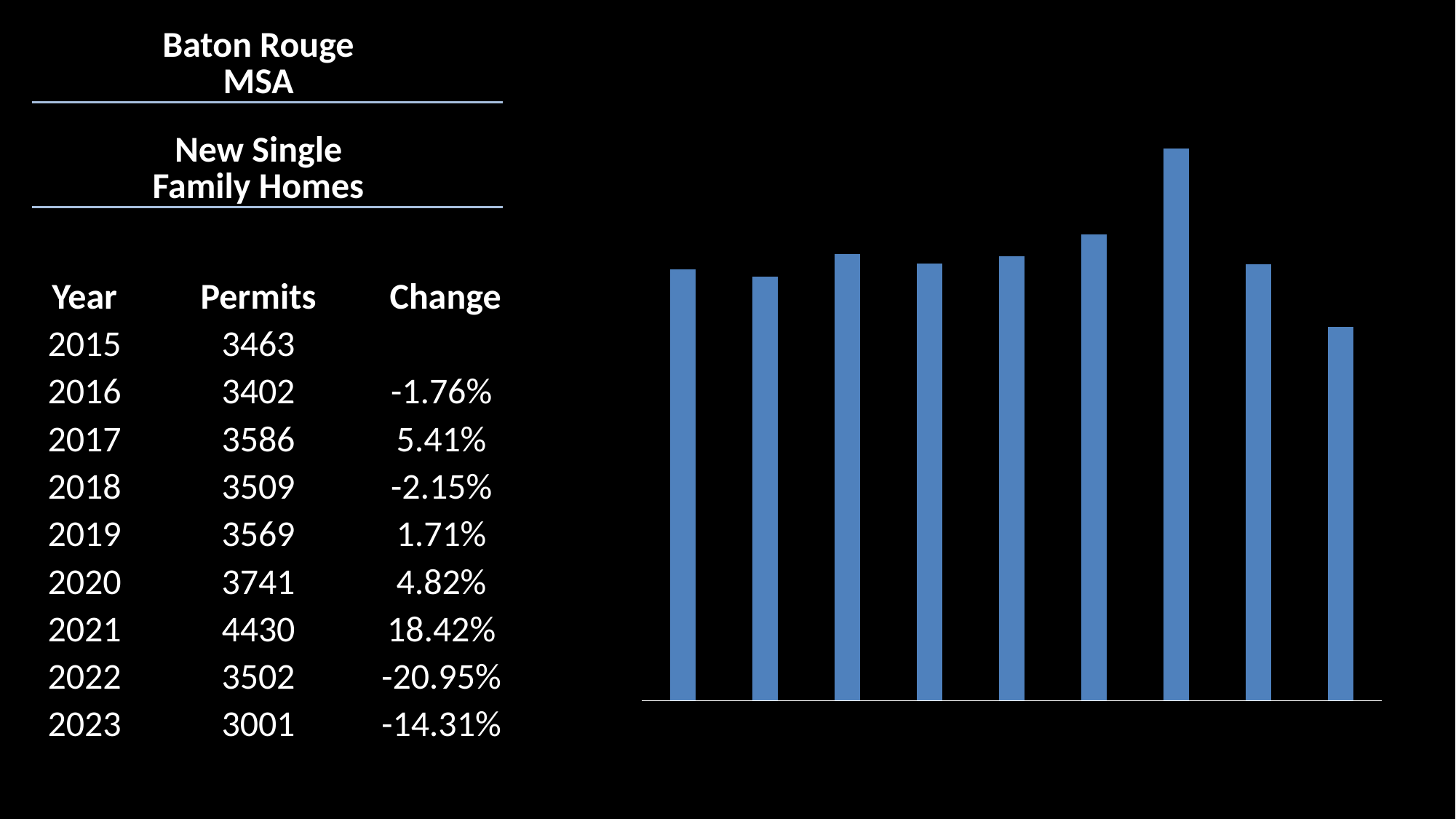
What is the difference in permits between 2021 and 2023? 1429 What kind of chart is shown on the right of the slide? bar chart Which year had more permits, 2020 or 2022? 2020 Do the bars rise or fall from 2021 to 2023? fall Which year has the shortest bar in the chart? 2023 What was the percentage change in permits in 2022? -20.95% How many new single family home permits were issued in the Baton Rouge MSA in 2021? 4430 What was the percentage change in permits in 2017? 5.41% How many permits were issued in 2015? 3463 Which year has the tallest bar in the chart? 2021 How many bars does the chart contain? 9 What colour are the bars in the chart? blue